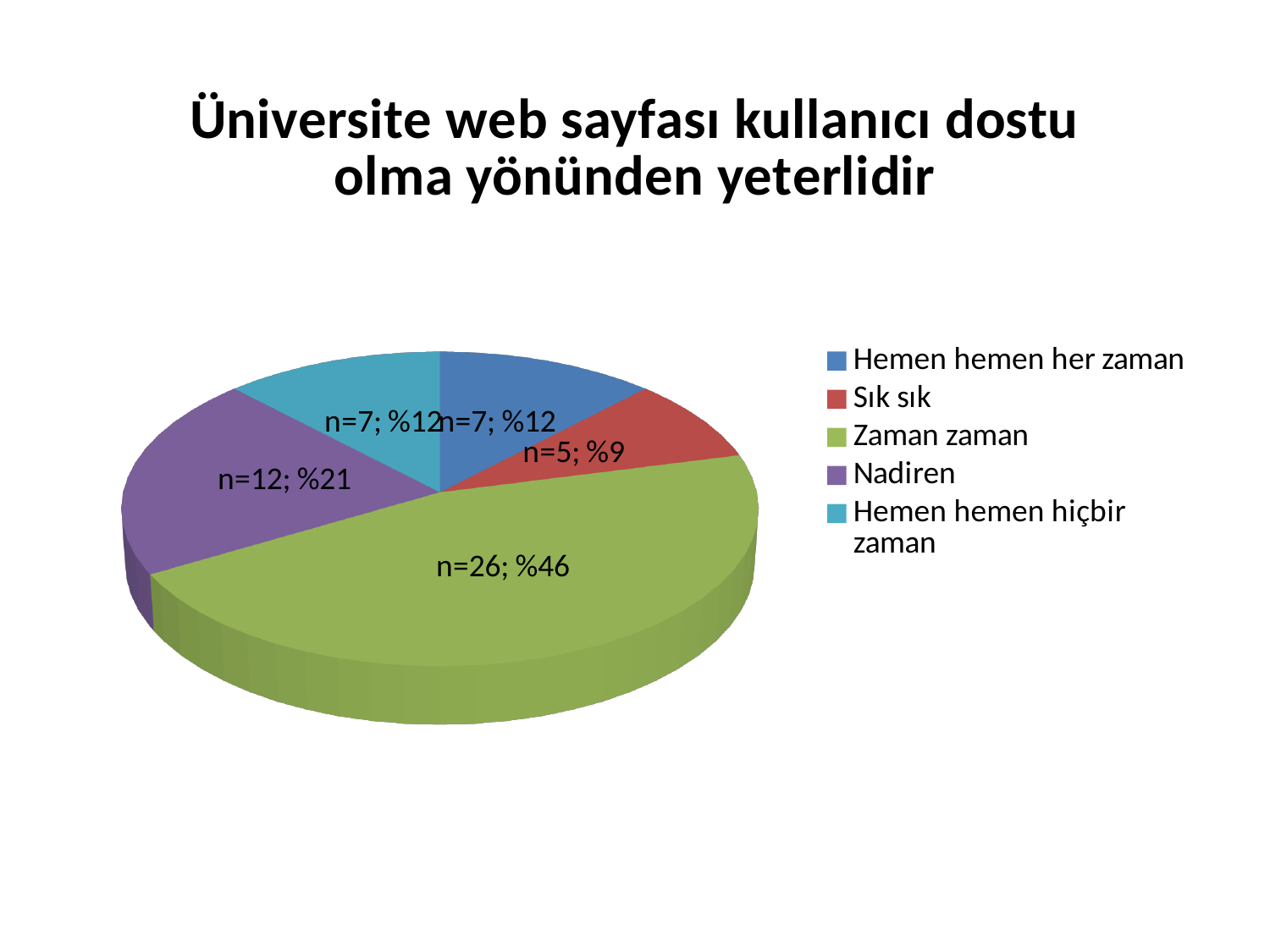
What colour is the 'Zaman zaman' slice? Green What kind of chart is shown on the slide? Pie chart How many categories does the legend list? 5 Which category has the smallest slice? Sık sık What is the data label for the 'Zaman zaman' slice? n=26; %46 What percentage share does the 'Hemen hemen her zaman' slice have? %12 What is the difference in n between 'Zaman zaman' and 'Nadiren'? 14 What is the title of the chart? Üniversite web sayfası kullanıcı dostu olma yönünden yeterlidir Which category has the largest slice? Zaman zaman What is the data label for the 'Nadiren' slice? n=12; %21 Which is larger, the 'Nadiren' slice or the 'Sık sık' slice? Nadiren What is the data label for the 'Sık sık' slice? n=5; %9